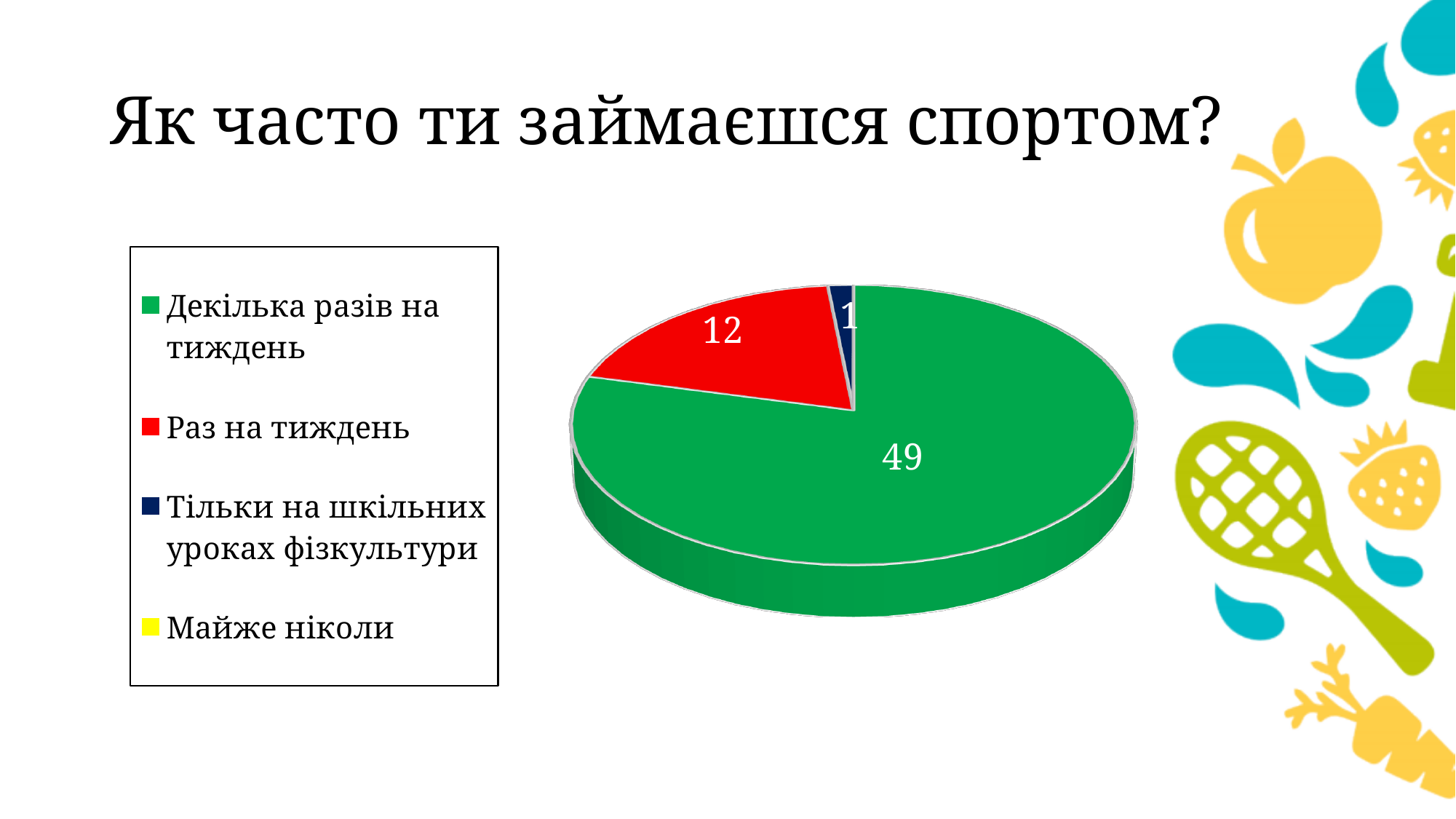
What is the difference between the values for "Раз на тиждень" and "Тільки на шкільних уроках фізкультури"? 11 How many categories does the legend list? 4 What is the value for "Раз на тиждень"? 12 Which labelled slice has the smallest value? Тільки на шкільних уроках фізкультури Which is larger: the value for "Раз на тиждень" or the value for "Тільки на шкільних уроках фізкультури"? Раз на тиждень What colour is the slice for "Раз на тиждень"? red What is the difference between the values for "Декілька разів на тиждень" and "Раз на тиждень"? 37 What is the title of the chart? Як часто ти займаєшся спортом? What is the value for "Декілька разів на тиждень"? 49 Which category has the largest slice of the pie? Декілька разів на тиждень What type of chart is shown on the slide? pie chart What is the value for "Тільки на шкільних уроках фізкультури"? 1